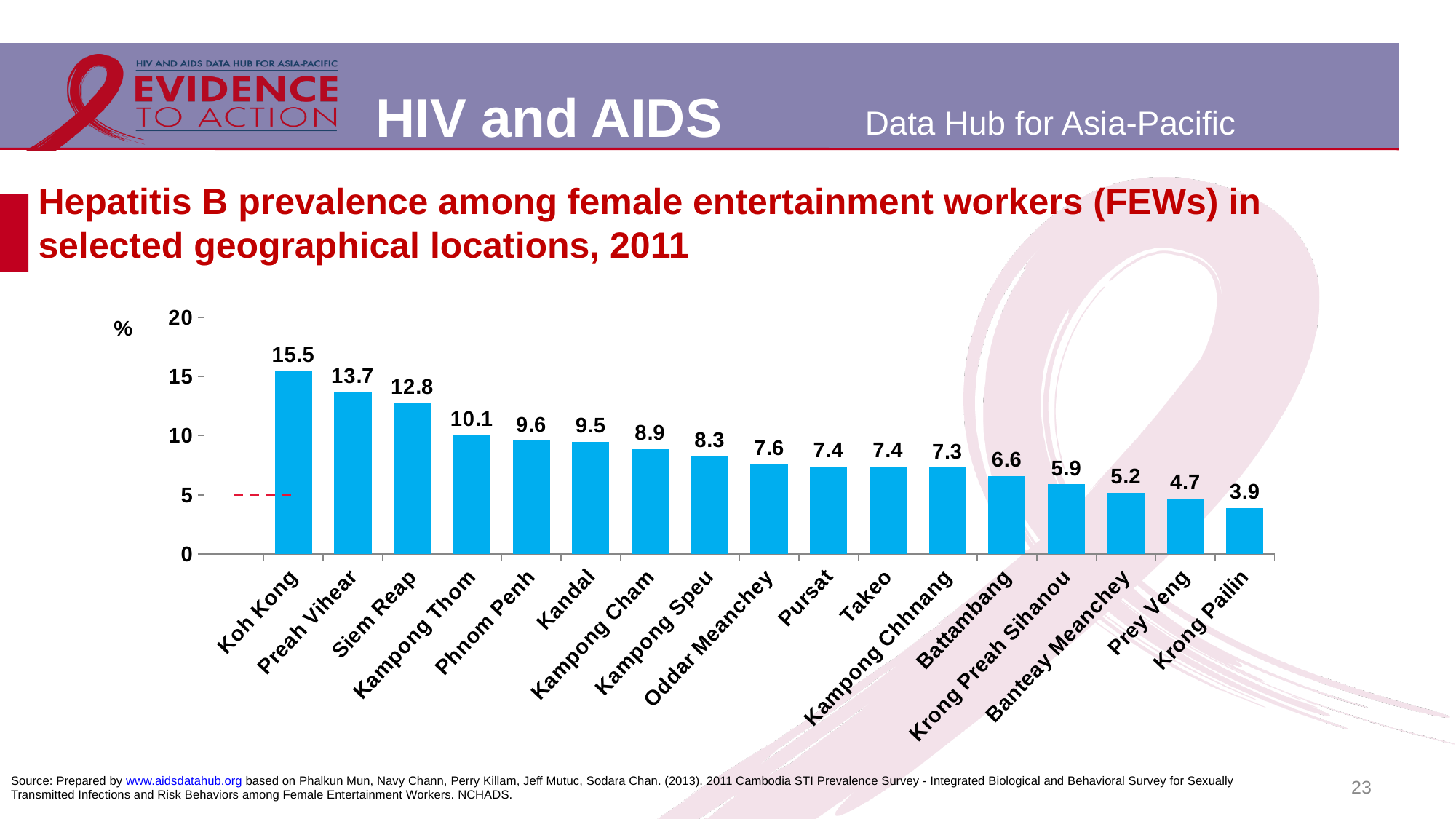
What is the value shown for Phnom Penh? 9.6 What is the value shown for Battambang? 6.6 What is the difference between the values for Preah Vihear and Siem Reap? 0.9 Do the values rise or fall from left to right along the x axis? fall What is the Hepatitis B prevalence among FEWs in Koh Kong? 15.5 Is the value for Prey Veng greater or less than 5? less Which has a higher value, Kampong Thom or Kandal? Kampong Thom Which location has the highest Hepatitis B prevalence? Koh Kong Which location has the lowest Hepatitis B prevalence? Krong Pailin How many locations are shown on the chart? 17 What kind of chart is shown on the slide? bar chart What is the difference between the values for Koh Kong and Krong Pailin? 11.6